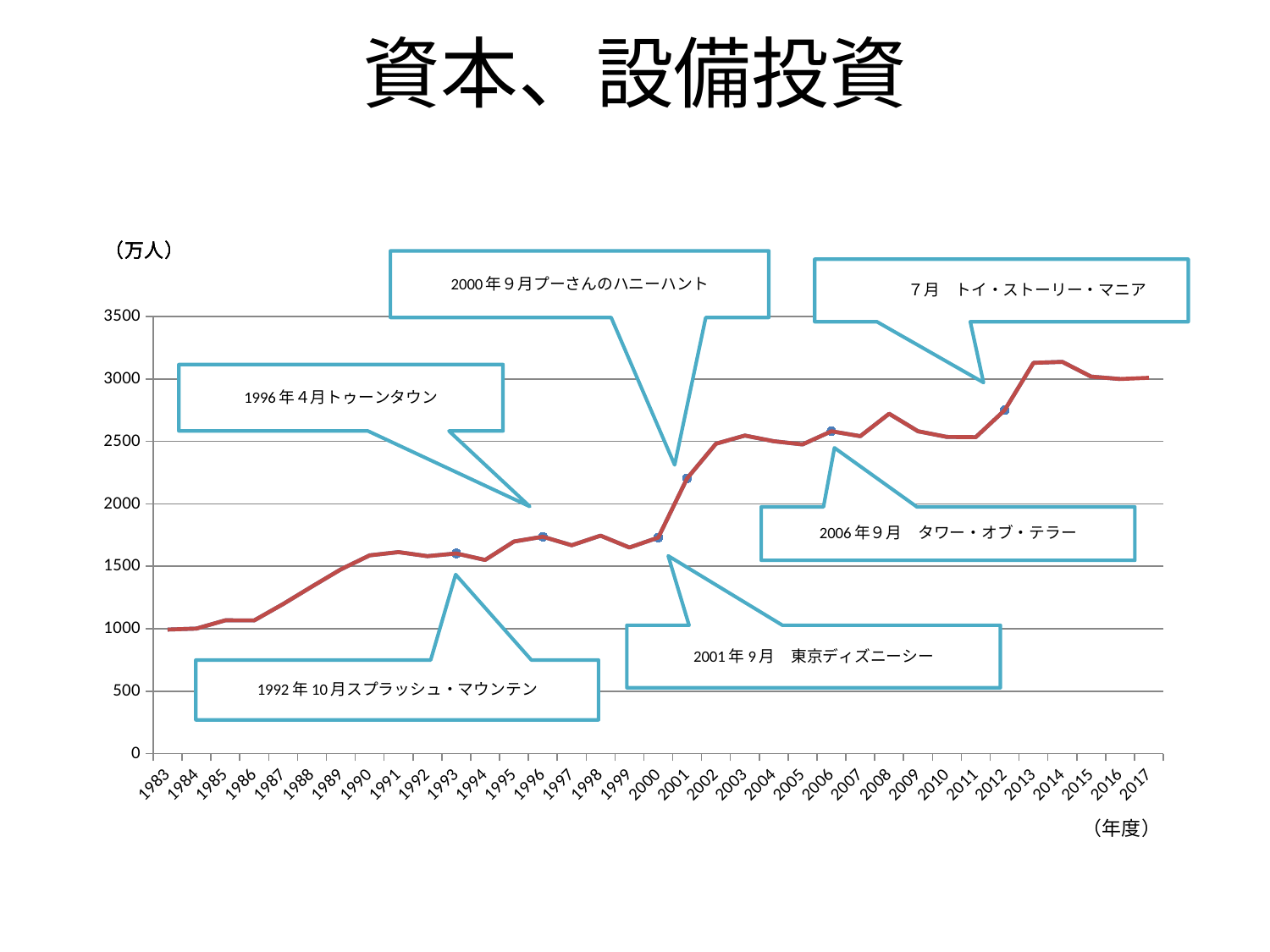
Is the value for 2013 greater or less than 3000? greater How many years are shown along the x axis of the chart? 35 Overall, do the values rise or fall from 1983 to 2017? rise Is the value for 2006 greater or less than 2500? greater Is the value for 1988 greater or less than 1500? less Which year has the larger value, 2000 or 2001? 2001 Which year has the larger value, 1993 or 2012? 2012 What kind of chart is shown on the slide? line chart What unit is shown at the top of the y axis? 万人